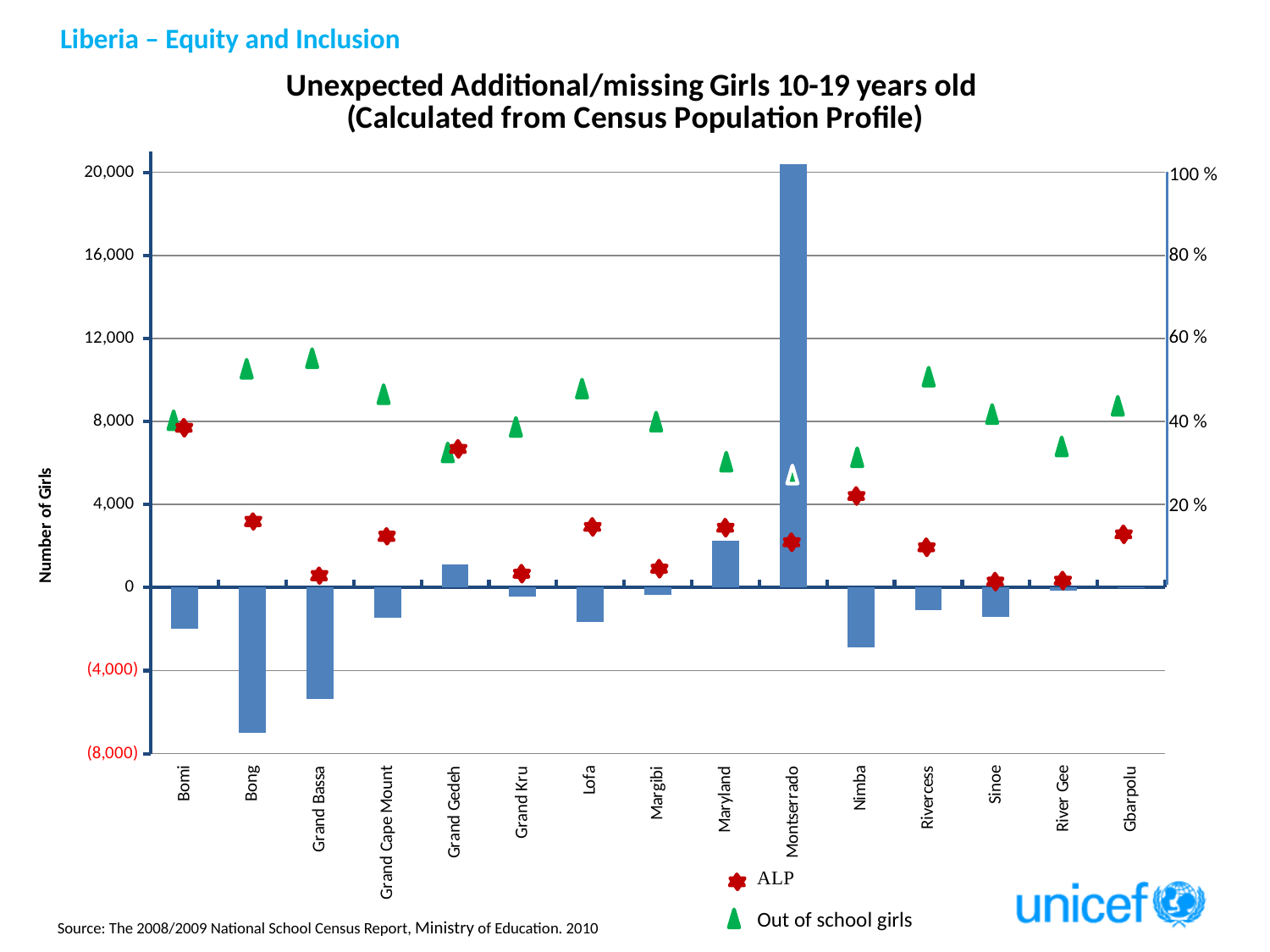
Which county has the highest ALP value? Bomi Is the Out of school girls value for Maryland greater or less than 40 %? less Which has the larger Out of school girls value, Lofa or Margibi? Lofa How many counties are shown along the x axis of the chart? 15 How many series does the chart's legend list? 2 Which county has the highest bar for number of girls? Montserrado Is the bar value for Bong greater or less than (4,000)? less Is the ALP value for Bomi greater or less than 20 %? greater Which county has the lowest (most negative) bar for number of girls? Bong What is the label on the left vertical axis of the chart? Number of Girls What kind of chart is shown on the slide? bar chart